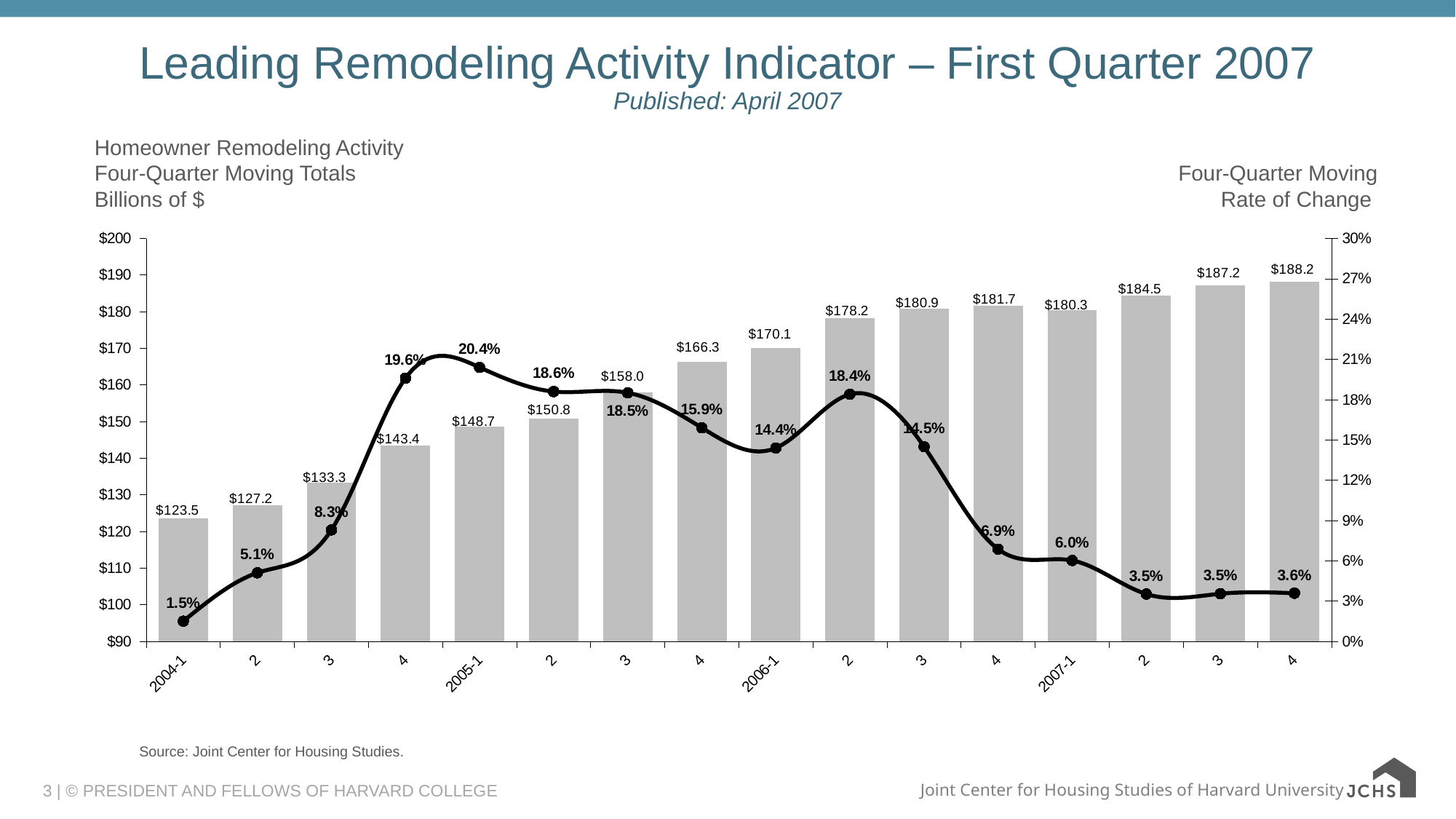
Which quarter has the highest four-quarter moving rate of change? 2005-1 Which is larger, the four-quarter moving total for the fourth quarter of 2006 or for 2007-1? Fourth quarter of 2006 ($181.7) Is the four-quarter moving rate of change for the fourth quarter of 2004 greater or less than 15%? greater What is the difference between the four-quarter moving totals for 2007-1 and 2006-1? $10.2 How many quarters are shown on the x axis? 16 Does the four-quarter moving rate of change rise or fall from 2006-2 to 2007-2? Fall What is the four-quarter moving total for the fourth quarter of 2007? $188.2 What is the four-quarter moving total for 2006-1? $170.1 What unit is used for the left axis of the chart? Billions of $ What kinds of chart are combined on this slide? A bar chart and a line chart What is the four-quarter moving rate of change for 2005-1? 20.4% Which quarter has the lowest four-quarter moving total? 2004-1